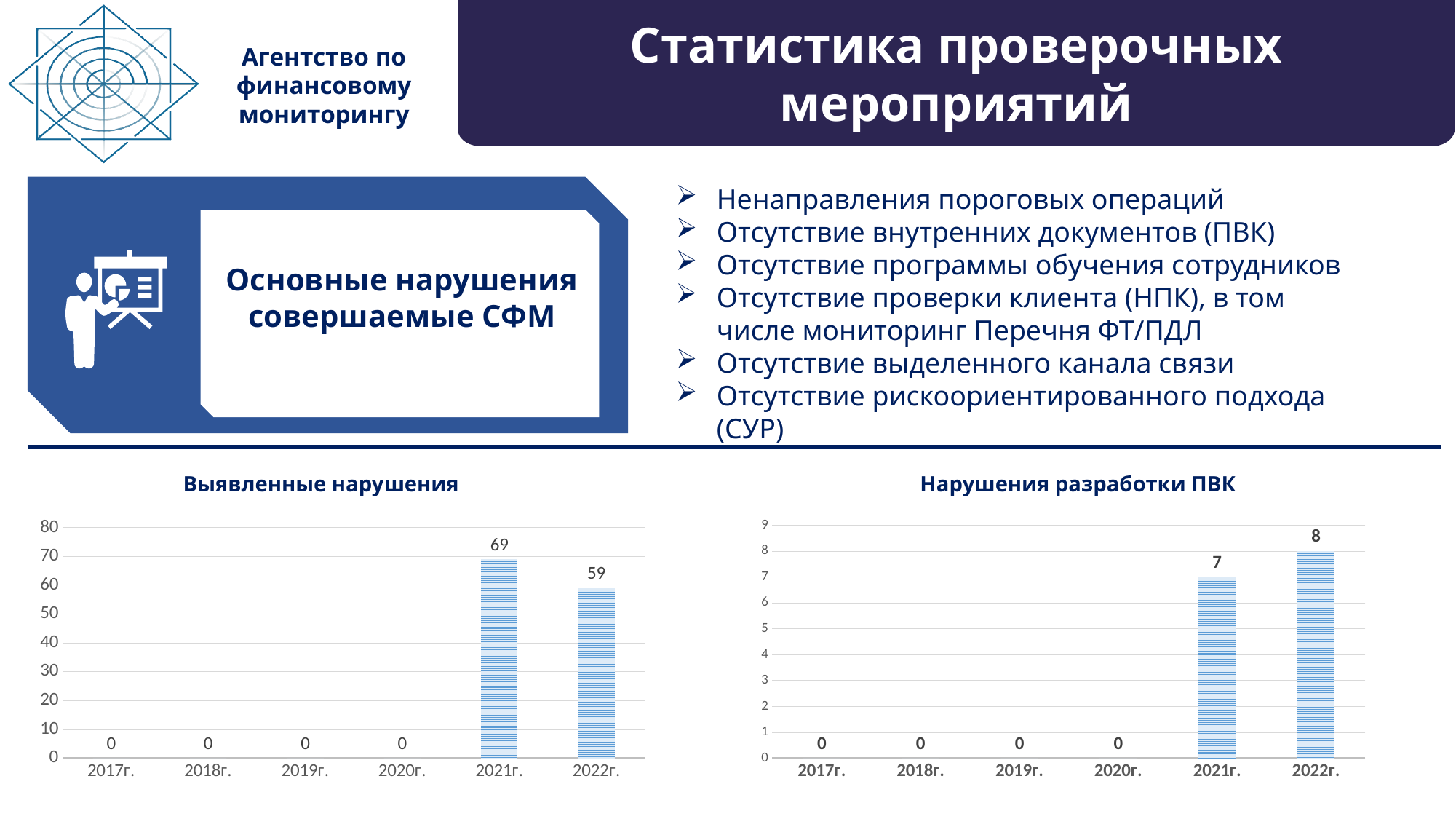
What kind of chart is the chart titled "Нарушения разработки ПВК"? bar chart In the chart titled "Выявленные нарушения", which year has the highest value? 2021г. In the chart titled "Выявленные нарушения", what is the difference between the values for 2021г. and 2022г.? 10 In the chart titled "Выявленные нарушения", how many years are shown on the x axis? 6 In the chart titled "Нарушения разработки ПВК", what is the value for 2021г.? 7 In the chart titled "Нарушения разработки ПВК", is the value for 2022г. larger or smaller than the value for 2021г.? larger In the chart titled "Выявленные нарушения", what is the value for 2019г.? 0 In the chart titled "Нарушения разработки ПВК", which year has the highest value? 2022г. In the chart titled "Выявленные нарушения", is the value for 2022г. greater or less than 50? greater In the chart titled "Выявленные нарушения", what is the value for 2021г.? 69 In the chart titled "Выявленные нарушения", what is the value for 2022г.? 59 In the chart titled "Нарушения разработки ПВК", what is the value for 2022г.? 8